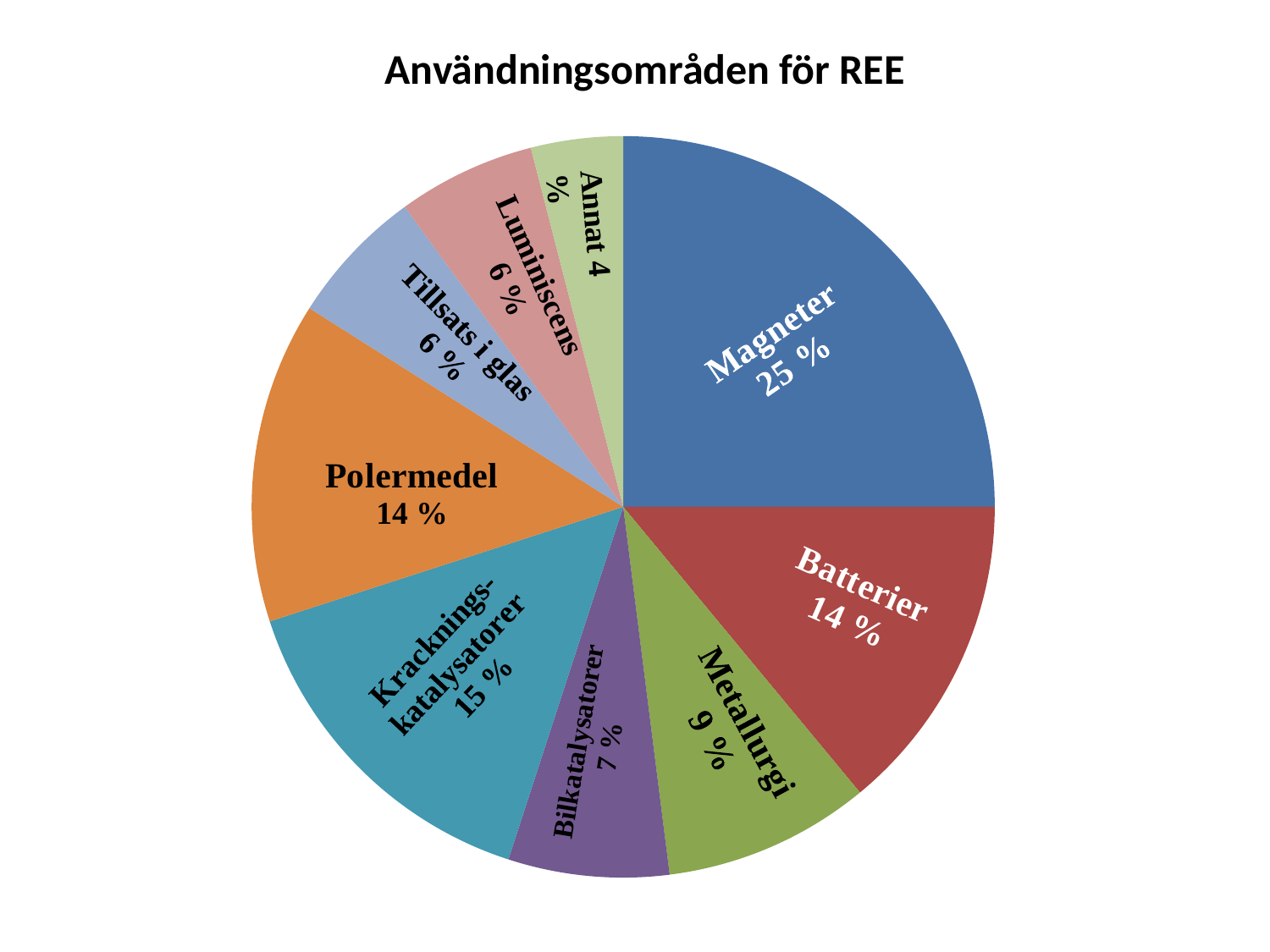
How many slices does the pie chart have? 9 What share of the pie does Magneter have? 25 % Which category has the smallest slice of the pie? Annat Which is larger, the share for Metallurgi or the share for Bilkatalysatorer? Metallurgi What is the title of the chart? Användningsområden för REE What share of the pie does Annat have? 4 % What is the difference in percentage points between Magneter and Batterier? 11 What kind of chart is shown on the slide? Pie chart What share of the pie does Bilkatalysatorer have? 7 % Which category has the largest slice of the pie? Magneter What is the combined share of Tillsats i glas and Luminiscens? 12 % What share of the pie does Krackningskatalysatorer have? 15 %